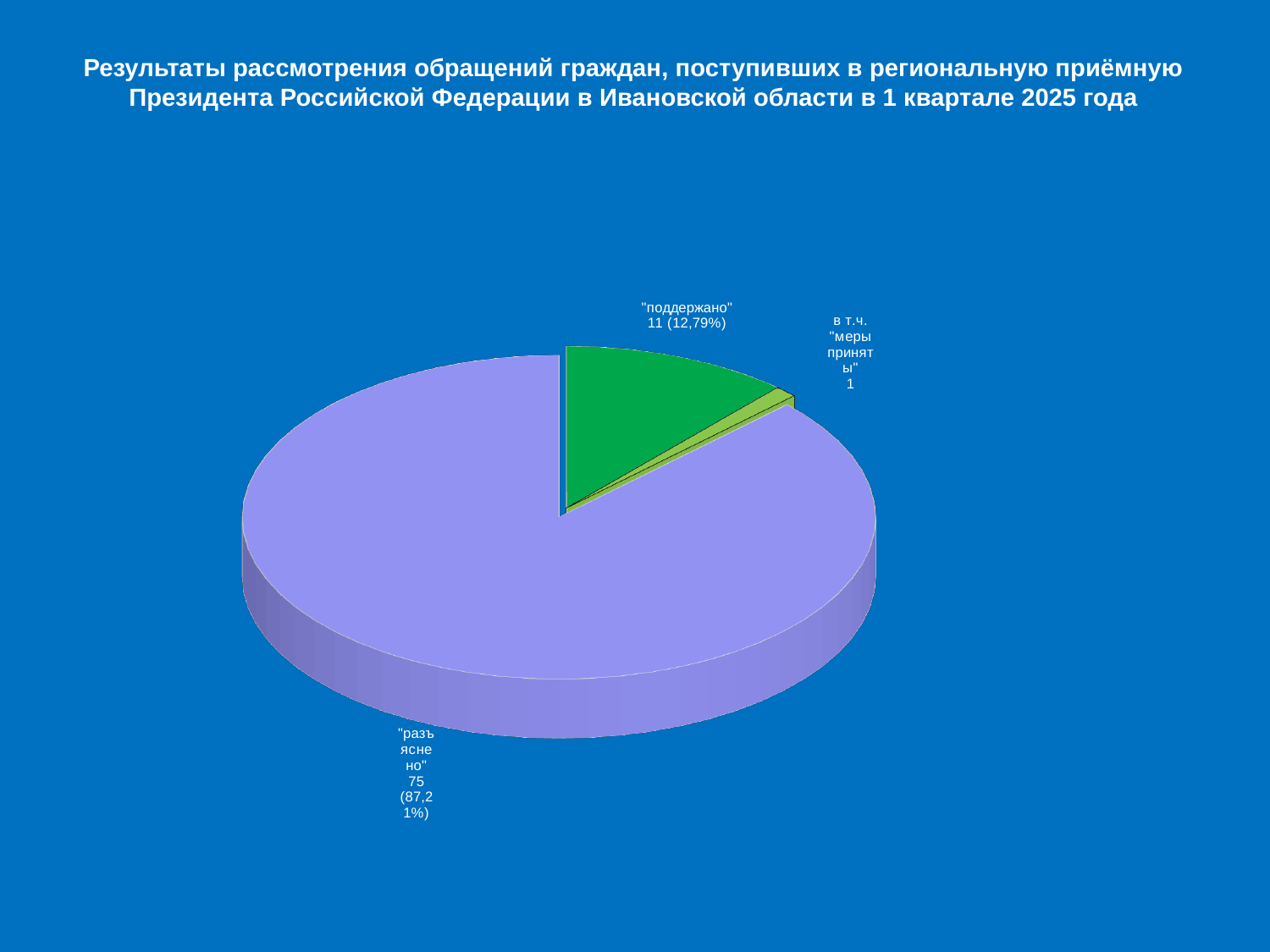
How many slices does the pie chart have? 3 What share of the pie does "разъяснено" represent? 87,21% Which is larger, the value for "поддержано" or the value for в т.ч. "меры приняты"? "поддержано" What is the value for "поддержано"? 11 What kind of chart is shown on the slide? pie chart What is the value for "разъяснено"? 75 What is the value for в т.ч. "меры приняты"? 1 Which category has the smallest slice? в т.ч. "меры приняты" What colour is the "разъяснено" slice? light purple What is the difference between the values for "разъяснено" and "поддержано"? 64 Which category has the largest slice? "разъяснено" What share of the pie does "поддержано" represent? 12,79%